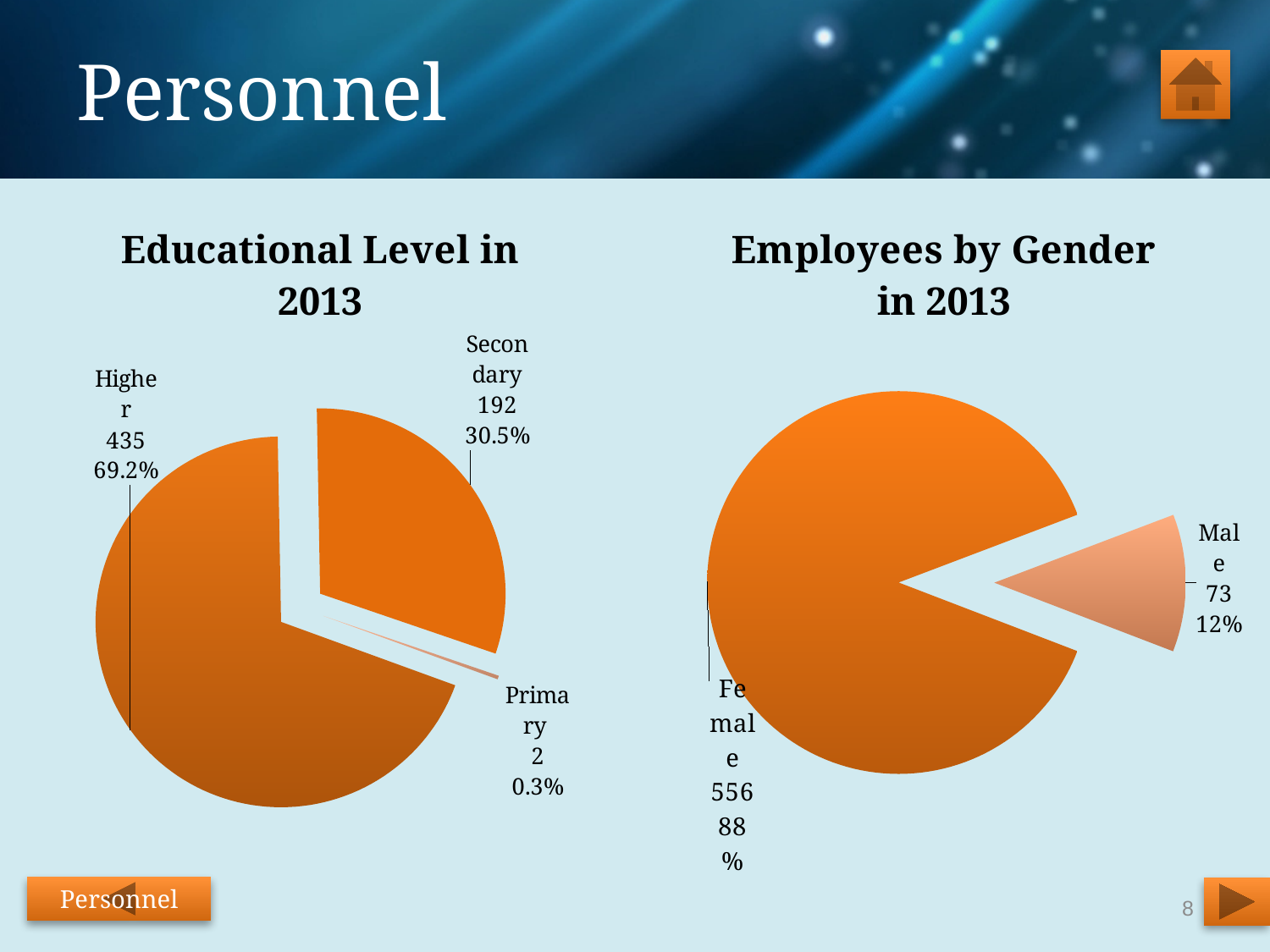
In the 'Educational Level in 2013' chart, which category has the smallest value? Primary What is the title of the chart on the left side of the slide? Educational Level in 2013 What kind of chart is 'Employees by Gender in 2013'? Pie chart In the 'Educational Level in 2013' chart, what is the difference between the Higher and Secondary values? 243 In the 'Educational Level in 2013' chart, what percentage share does Secondary have? 30.5% In the 'Employees by Gender in 2013' chart, what is the difference between the Female and Male values? 483 In the 'Educational Level in 2013' chart, what is the value for Higher? 435 In the 'Educational Level in 2013' chart, which category has the largest value? Higher In the 'Employees by Gender in 2013' chart, what percentage share does Female have? 88% In the 'Educational Level in 2013' chart, how many categories are shown? 3 In the 'Employees by Gender in 2013' chart, which is larger, Female or Male? Female In the 'Employees by Gender in 2013' chart, what is the value for Male? 73